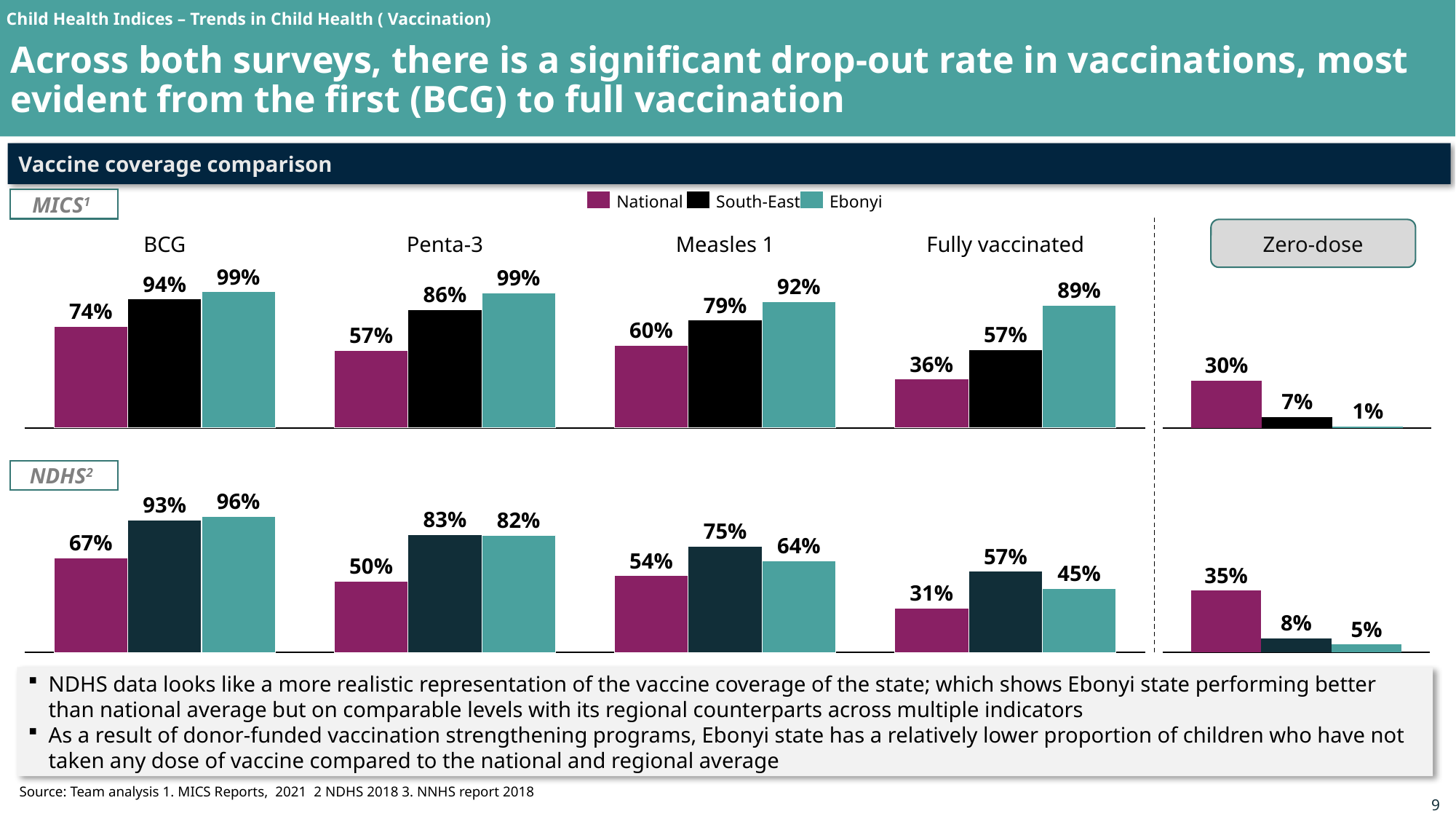
In the NDHS chart, which is larger for Penta-3: the South-East value or the Ebonyi value? South-East How many series does the legend list? 3 In the MICS chart, what is the Ebonyi value for BCG? 99% In the NDHS chart, what is the difference between the South-East and Ebonyi values for Measles 1? 11% In the NDHS chart, what is the Ebonyi value for Zero-dose? 5% What kind of chart is used to show the vaccine coverage comparison? Bar chart In the MICS chart, what is the difference between the Ebonyi and National values for Fully vaccinated? 53% In the MICS chart, which series has the highest value for Measles 1? Ebonyi In the NDHS chart, what is the National value for Fully vaccinated? 31% In the NDHS chart, which series has the lowest value for Zero-dose? Ebonyi Which colour represents the National series in the legend? Purple In the MICS chart, what is the South-East value for Penta-3? 86%